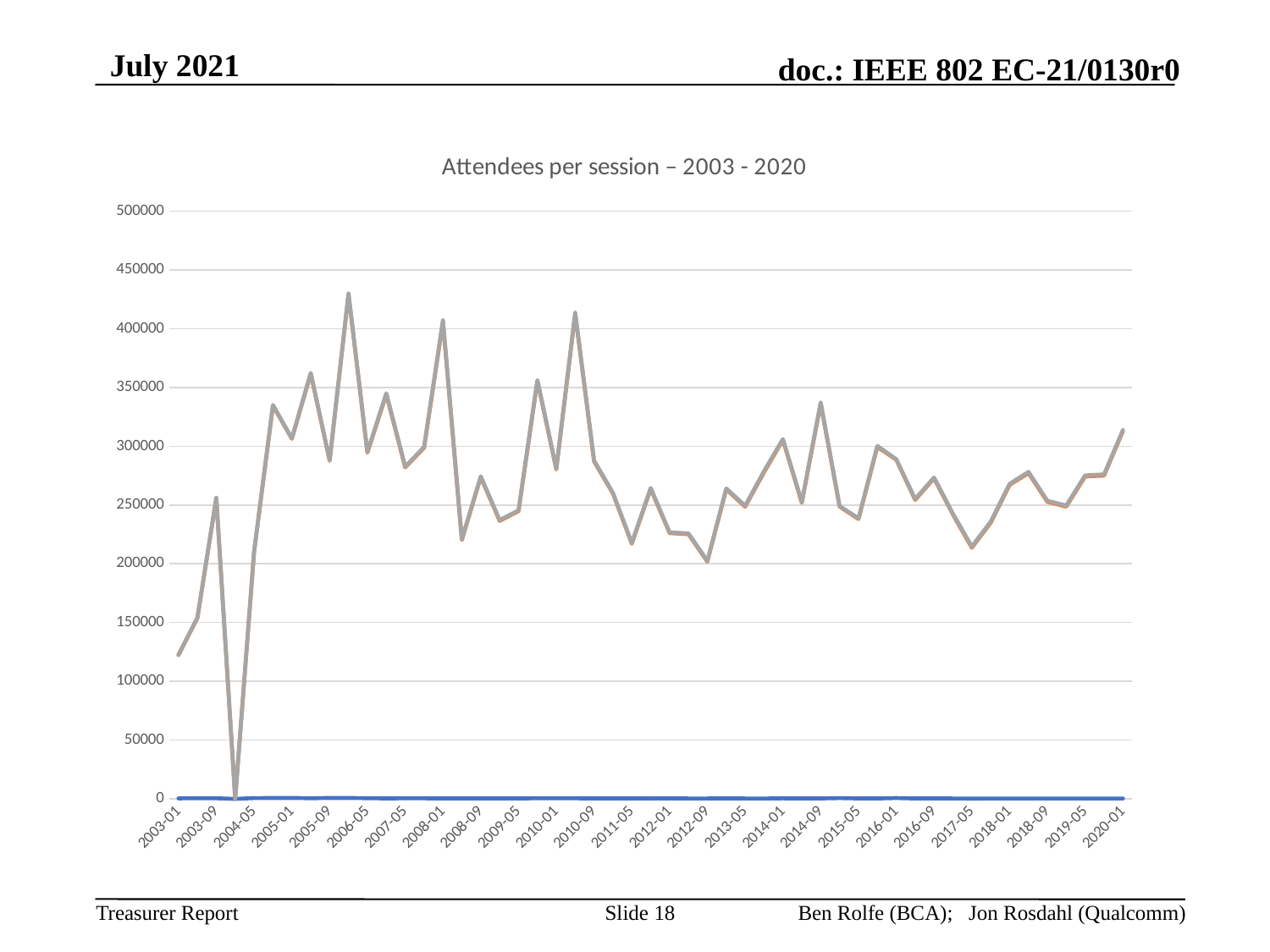
What is the highest value shown on the y axis? 500000 Is the value for 2008-01 greater or less than 350000? greater What kind of chart is shown on the slide? line chart Does the value rise or fall from 2014-09 to 2015-05? fall Is the value for 2017-05 greater or less than 250000? less What is the title of the chart? Attendees per session – 2003 - 2020 Is the value for 2003-01 greater or less than 150000? less Which is larger, the value for 2008-01 or the value for 2017-05? 2008-01 Which is larger, the value for 2003-01 or the value for 2020-01? 2020-01